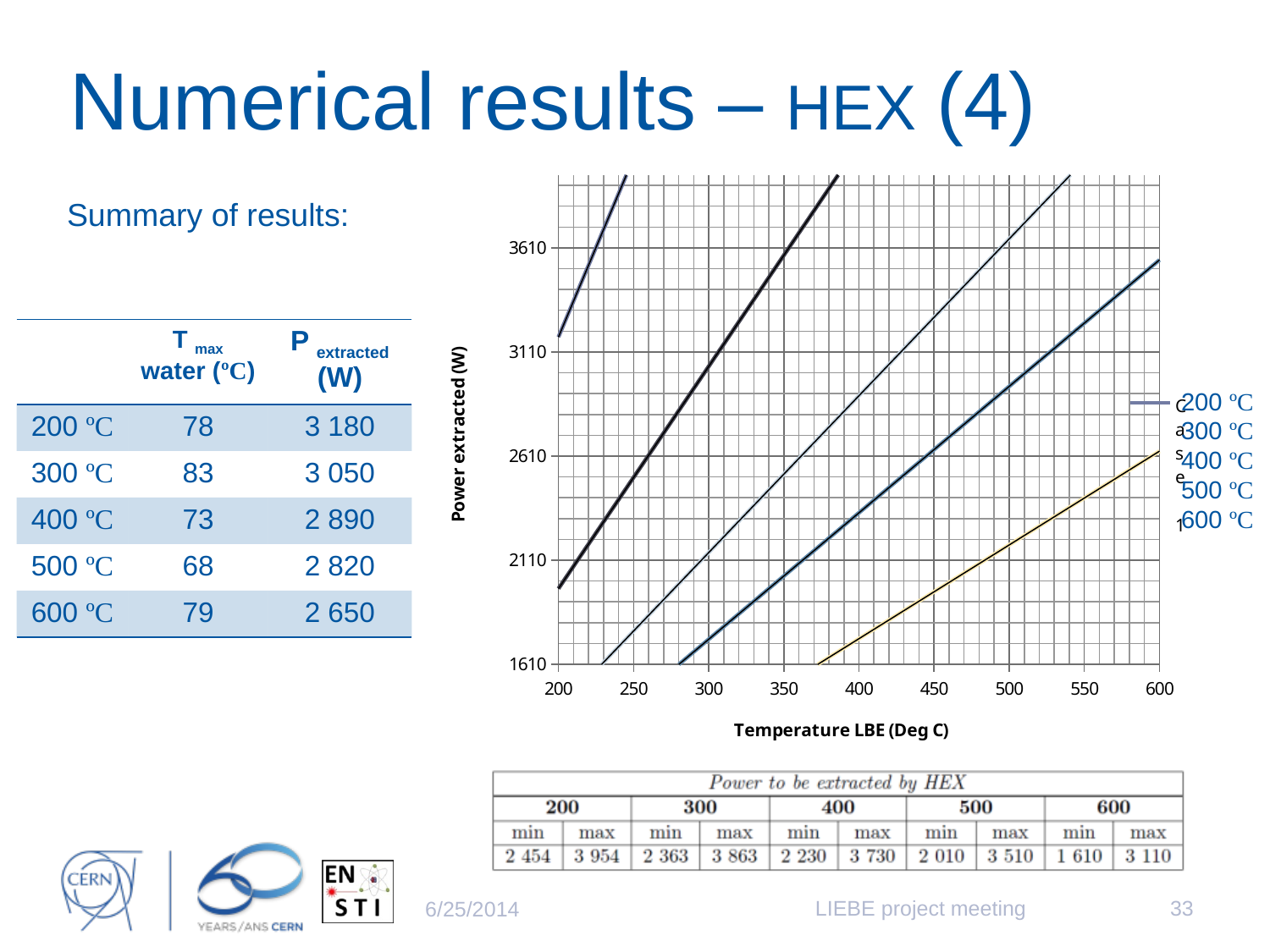
Which series has the lowest power extracted at a Temperature LBE of 500? 600 °C Is the value of the 500 °C series at a Temperature LBE of 550 greater or less than 2610? greater Is the value of the 600 °C series at a Temperature LBE of 450 greater or less than 2110? less How many series does the chart's legend list? 5 What kind of chart is shown on the slide? line chart Is the value of the 400 °C series at a Temperature LBE of 350 greater or less than 2610? less Do the values of the 500 °C series rise or fall as Temperature LBE increases? rise At a Temperature LBE of 550, which series has the larger power extracted, 500 °C or 600 °C? 500 °C At a Temperature LBE of 300, which series has the larger power extracted, 300 °C or 400 °C? 300 °C What is the title of the chart's x axis? Temperature LBE (Deg C) What is the title of the chart's y axis? Power extracted (W) Which series has the highest power extracted at a Temperature LBE of 200? 200 °C